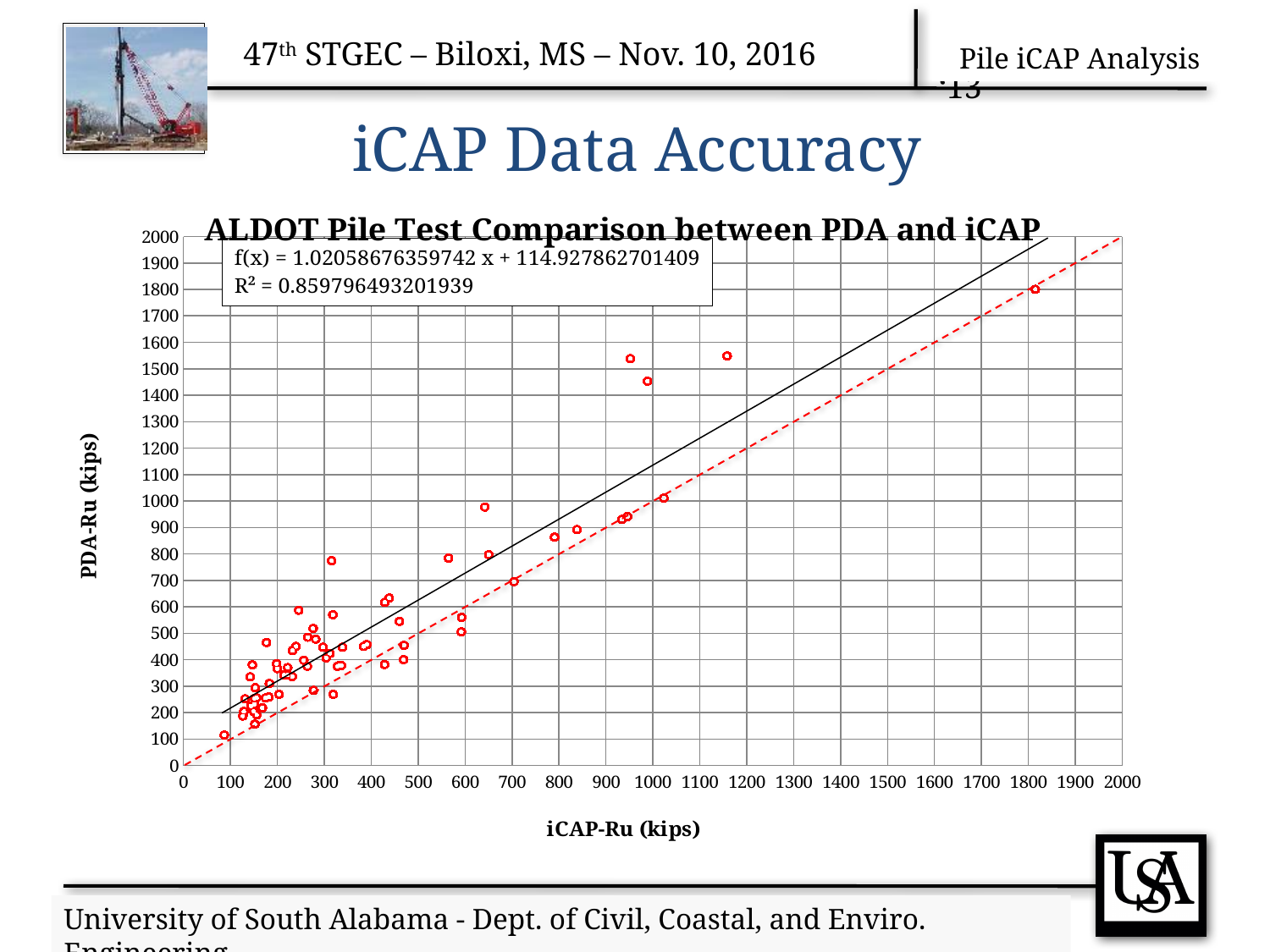
What is the slope of the trendline equation printed on the chart? 1.02058676359742 Is the iCAP-Ru value of the rightmost plotted point greater or less than 1700? greater Is the PDA-Ru value of the lowest plotted point greater or less than 200? less What is the maximum value shown on the y axis of the chart? 2000 Is the PDA-Ru value of the plotted point near iCAP-Ru = 1150 greater or less than 1400? greater What is the title of the chart? ALDOT Pile Test Comparison between PDA and iCAP What is the intercept of the trendline equation printed on the chart? 114.927862701409 As iCAP-Ru increases along the x axis, do the PDA-Ru values generally rise or fall? rise What kind of chart is shown on the slide? scatter chart What is the title of the x axis of the chart? iCAP-Ru (kips) What R² value is printed on the chart for the trendline? 0.859796493201939